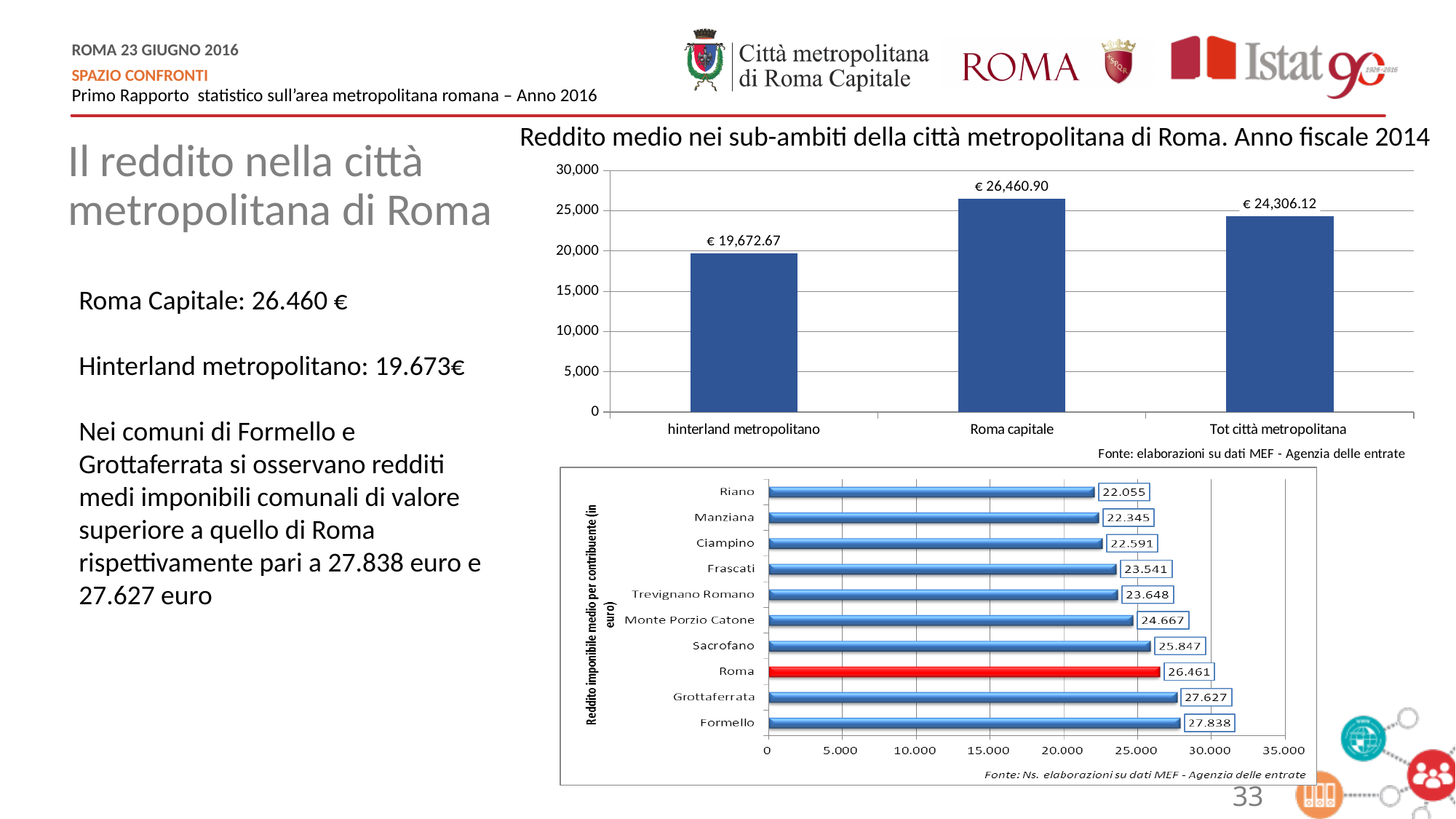
In the top chart 'Reddito medio nei sub-ambiti della città metropolitana di Roma', how many bars are plotted? 3 In the bottom chart of municipalities, what is the difference between Formello and Roma? 1.377 In the top chart 'Reddito medio nei sub-ambiti della città metropolitana di Roma', what is the value for Roma capitale? € 26,460.90 In the bottom chart of municipalities, which municipality has the highest value? Formello In the bottom chart of municipalities, which bar is coloured red? Roma In the top chart 'Reddito medio nei sub-ambiti della città metropolitana di Roma', what kind of chart is shown? bar chart In the bottom chart of municipalities, which municipality has the lowest value? Riano In the top chart 'Reddito medio nei sub-ambiti della città metropolitana di Roma', what is the value for hinterland metropolitano? € 19,672.67 In the bottom chart of municipalities, what is the value for Formello? 27.838 In the top chart 'Reddito medio nei sub-ambiti della città metropolitana di Roma', which category has the lowest value? hinterland metropolitano In the bottom chart of municipalities, what is the value for Sacrofano? 25.847 In the bottom chart of municipalities, which is larger, Ciampino or Frascati? Frascati